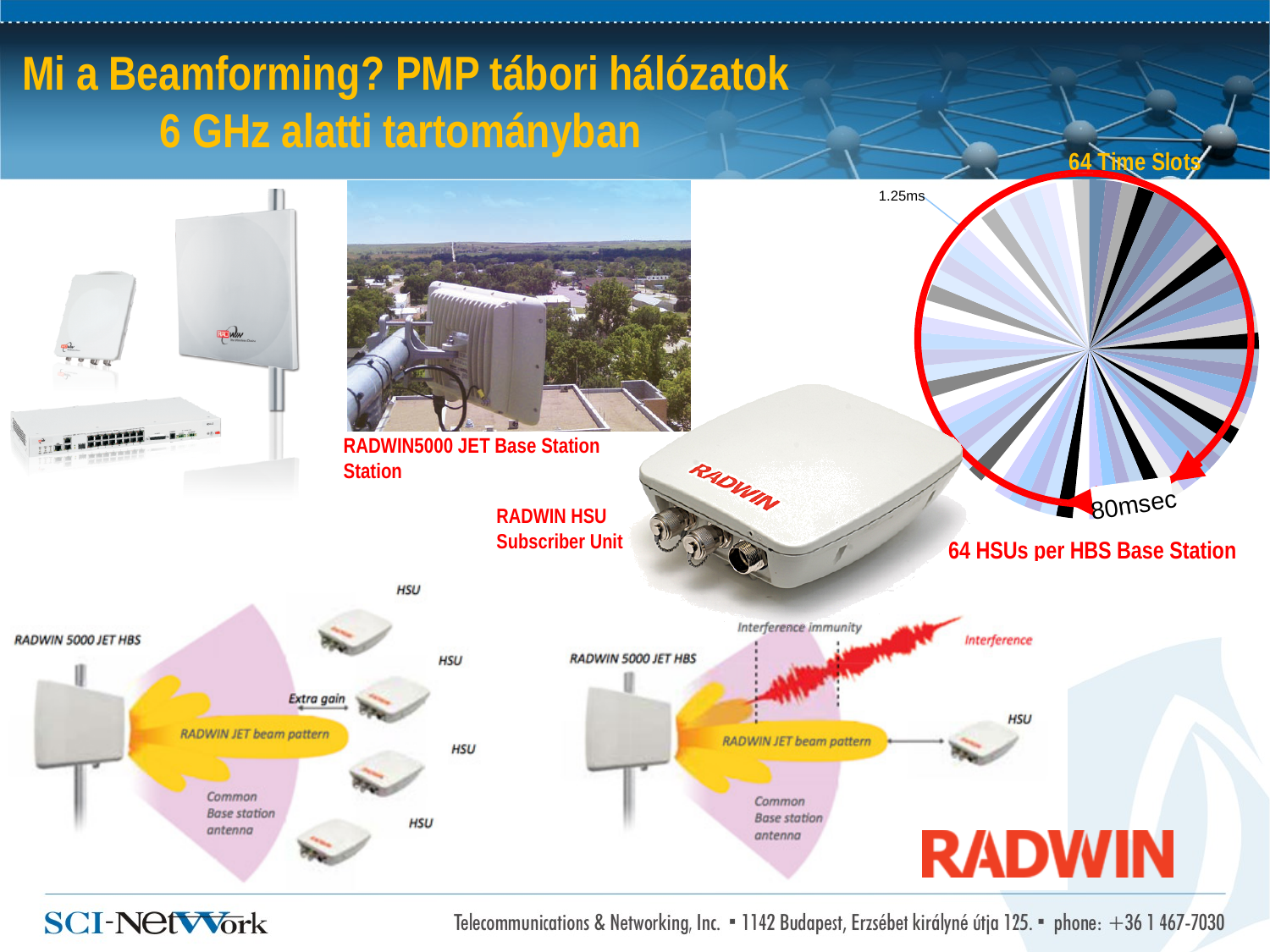
What caption is written directly below the pie chart in the top right? 64 HSUs per HBS Base Station What is the title written above the pie chart in the top right? 64 Time Slots In the pie chart in the top right, what duration is labelled for a single time slot? 1.25ms How many time slots does the pie chart in the top right represent? 64 What kind of chart is shown in the top right of the slide under the label "64 Time Slots"? pie chart In the pie chart in the top right, what total duration is labelled at the end of the red arrow around the circle? 80msec